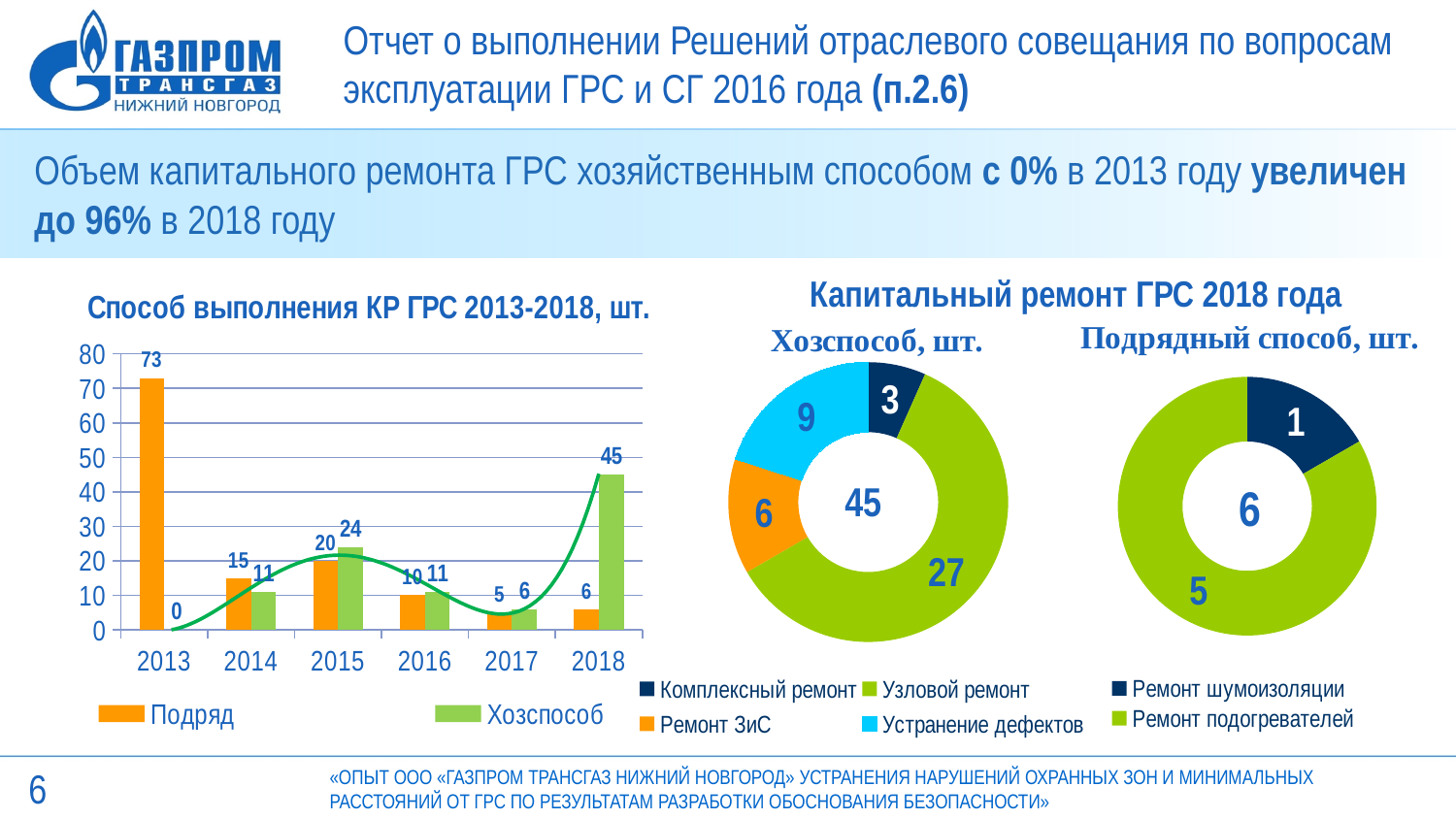
In the chart 'Способ выполнения КР ГРС 2013-2018, шт.', which is larger in 2014: Подряд or Хозспособ? Подряд In the donut chart 'Хозспособ, шт.', what is the value for Узловой ремонт? 27 How many years are shown on the x axis of the chart 'Способ выполнения КР ГРС 2013-2018, шт.'? 6 How many series does the legend of the chart 'Способ выполнения КР ГРС 2013-2018, шт.' list? 2 In the donut chart 'Хозспособ, шт.', which category has the smallest value? Комплексный ремонт In the chart 'Способ выполнения КР ГРС 2013-2018, шт.', what is the value for Хозспособ in 2018? 45 What kind of chart is 'Способ выполнения КР ГРС 2013-2018, шт.'? Bar chart In the chart 'Способ выполнения КР ГРС 2013-2018, шт.', which year has the lowest value for Подряд? 2017 In the chart 'Способ выполнения КР ГРС 2013-2018, шт.', what is the difference between Хозспособ and Подряд in 2015? 4 In the chart 'Способ выполнения КР ГРС 2013-2018, шт.', what is the value for Подряд in 2013? 73 In the donut chart 'Подрядный способ, шт.', what is the value for Ремонт подогревателей? 5 In the chart 'Способ выполнения КР ГРС 2013-2018, шт.', which year has the highest value for Хозспособ? 2018